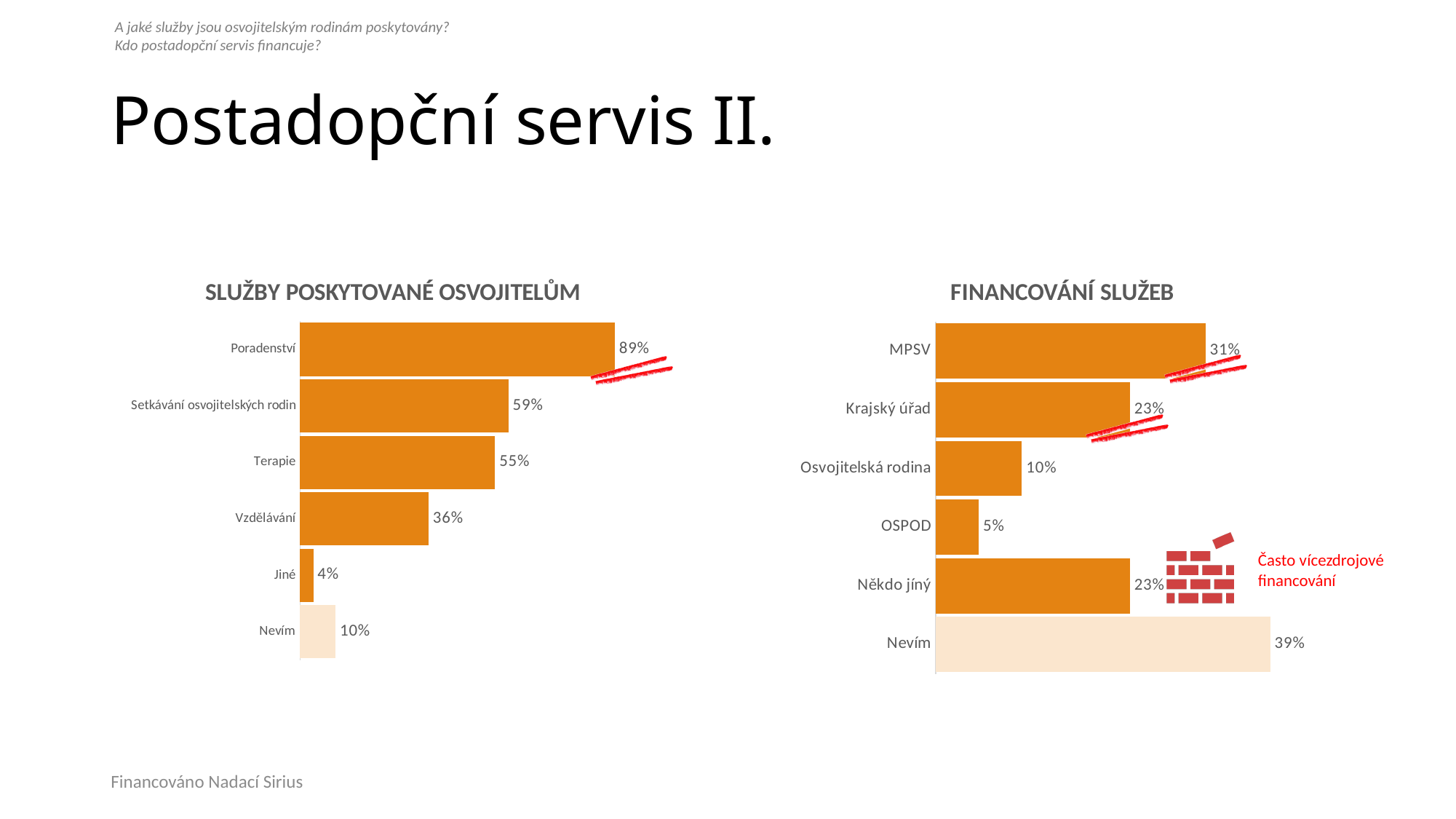
In the chart titled 'SLUŽBY POSKYTOVANÉ OSVOJITELŮM', which category has the lowest value? Jiné In the chart titled 'FINANCOVÁNÍ SLUŽEB', what is the value for MPSV? 31% In the chart titled 'SLUŽBY POSKYTOVANÉ OSVOJITELŮM', what is the value for Poradenství? 89% In the chart titled 'FINANCOVÁNÍ SLUŽEB', which category has the highest value? Nevím In the chart titled 'FINANCOVÁNÍ SLUŽEB', what is the difference between MPSV and Krajský úřad? 8% In the chart titled 'SLUŽBY POSKYTOVANÉ OSVOJITELŮM', what is the difference between Setkávání osvojitelských rodin and Terapie? 4% In the chart titled 'FINANCOVÁNÍ SLUŽEB', what is the value for OSPOD? 5% What is the title of the chart on the left side of the slide? SLUŽBY POSKYTOVANÉ OSVOJITELŮM What kind of chart is the chart titled 'FINANCOVÁNÍ SLUŽEB'? Bar chart In the chart titled 'SLUŽBY POSKYTOVANÉ OSVOJITELŮM', how many categories are shown? 6 In the chart titled 'FINANCOVÁNÍ SLUŽEB', which is larger: Krajský úřad or Osvojitelská rodina? Krajský úřad In the chart titled 'SLUŽBY POSKYTOVANÉ OSVOJITELŮM', what is the value for Vzdělávání? 36%